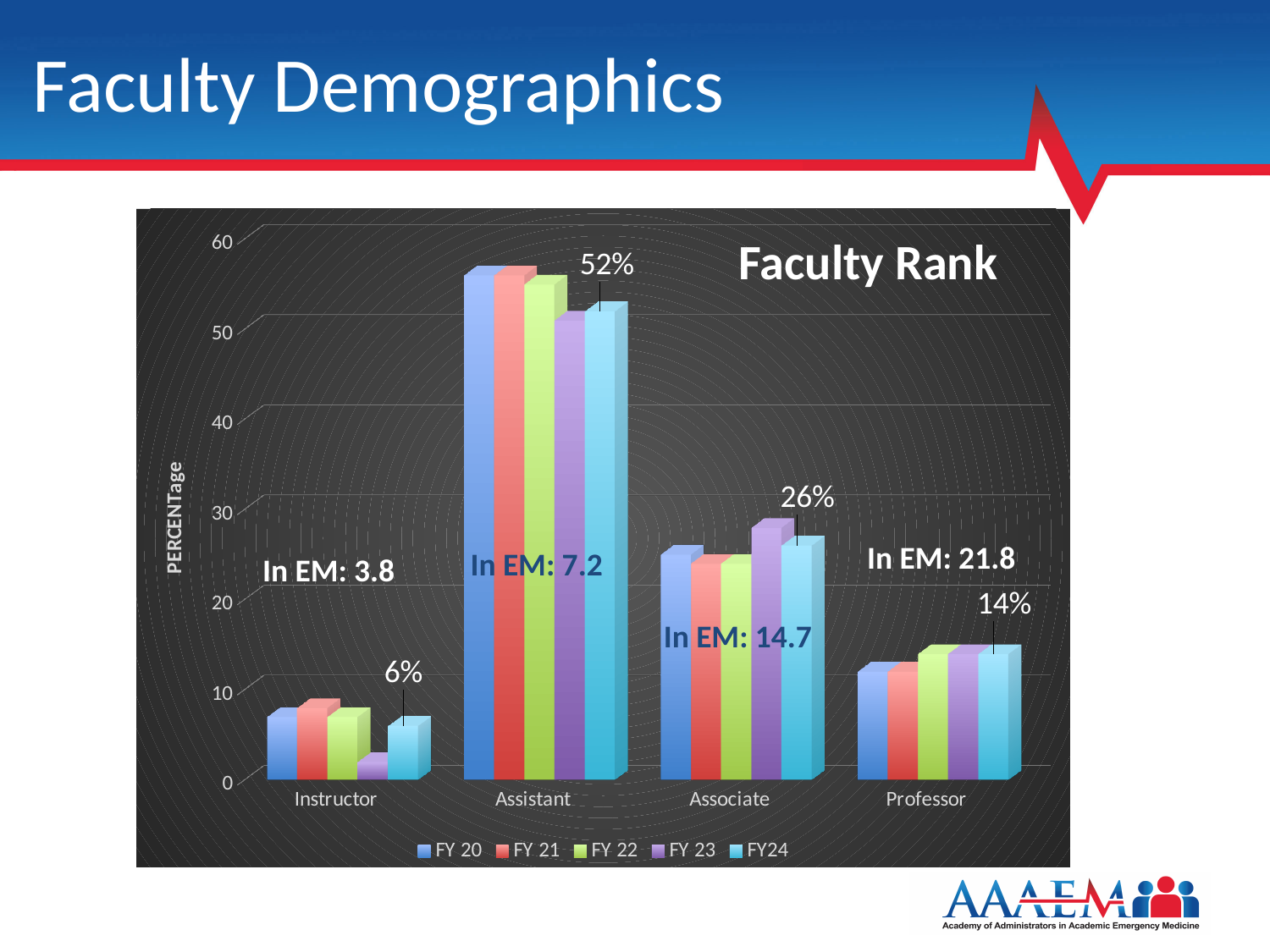
What kind of chart is shown on the slide? Bar chart In the Faculty Rank chart, what is the difference between the FY24 values for Assistant and Associate? 26% In the Faculty Rank chart, what is the FY24 value for Assistant? 52% In the Faculty Rank chart, which faculty rank has the highest FY24 value? Assistant How many faculty rank categories are shown on the x axis of the chart? 4 In the Faculty Rank chart, what is the FY24 value for Instructor? 6% How many series does the legend of the Faculty Rank chart list? 5 In the Faculty Rank chart, which is larger for FY24: Associate or Professor? Associate In the Faculty Rank chart, is the FY 23 value for Instructor greater or less than 10? less In the Faculty Rank chart, is the FY 20 value for Assistant greater or less than 50? greater In the Faculty Rank chart, what is the FY24 value for Professor? 14% In the Faculty Rank chart, which faculty rank has the lowest FY24 value? Instructor